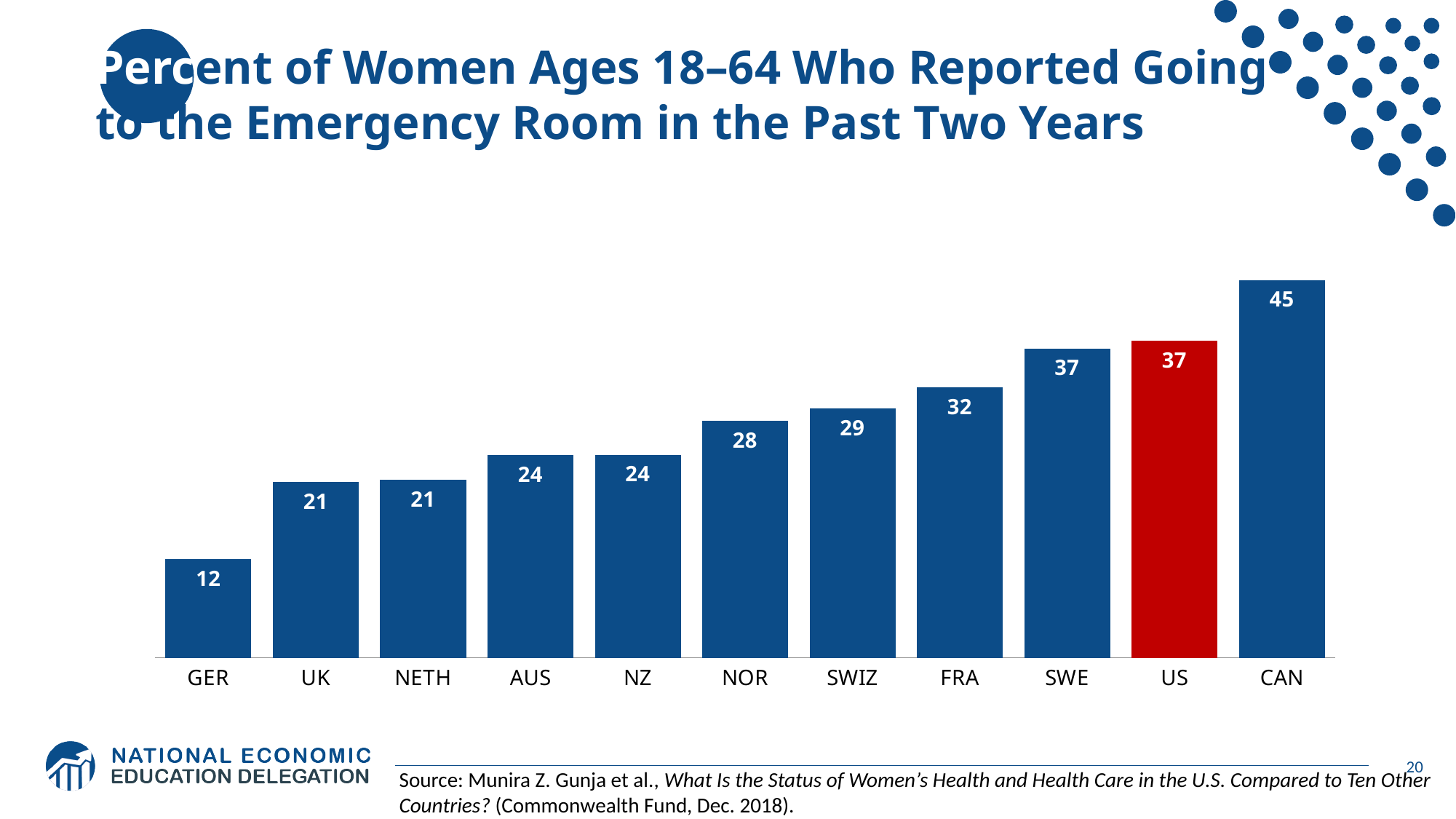
What is the difference between the values for CAN and the US? 8 Do the values rise or fall from left to right across the countries? rise How many countries are shown on the chart? 11 What is the difference between the values for FRA and GER? 20 What is the value for the US? 37 What is the value for GER? 12 Which country has the highest value? CAN Which country's bar is coloured red? US What kind of chart is shown on the slide? bar chart What is the value for NOR? 28 Which is larger, the value for SWIZ or the value for AUS? SWIZ Which country has the lowest value? GER